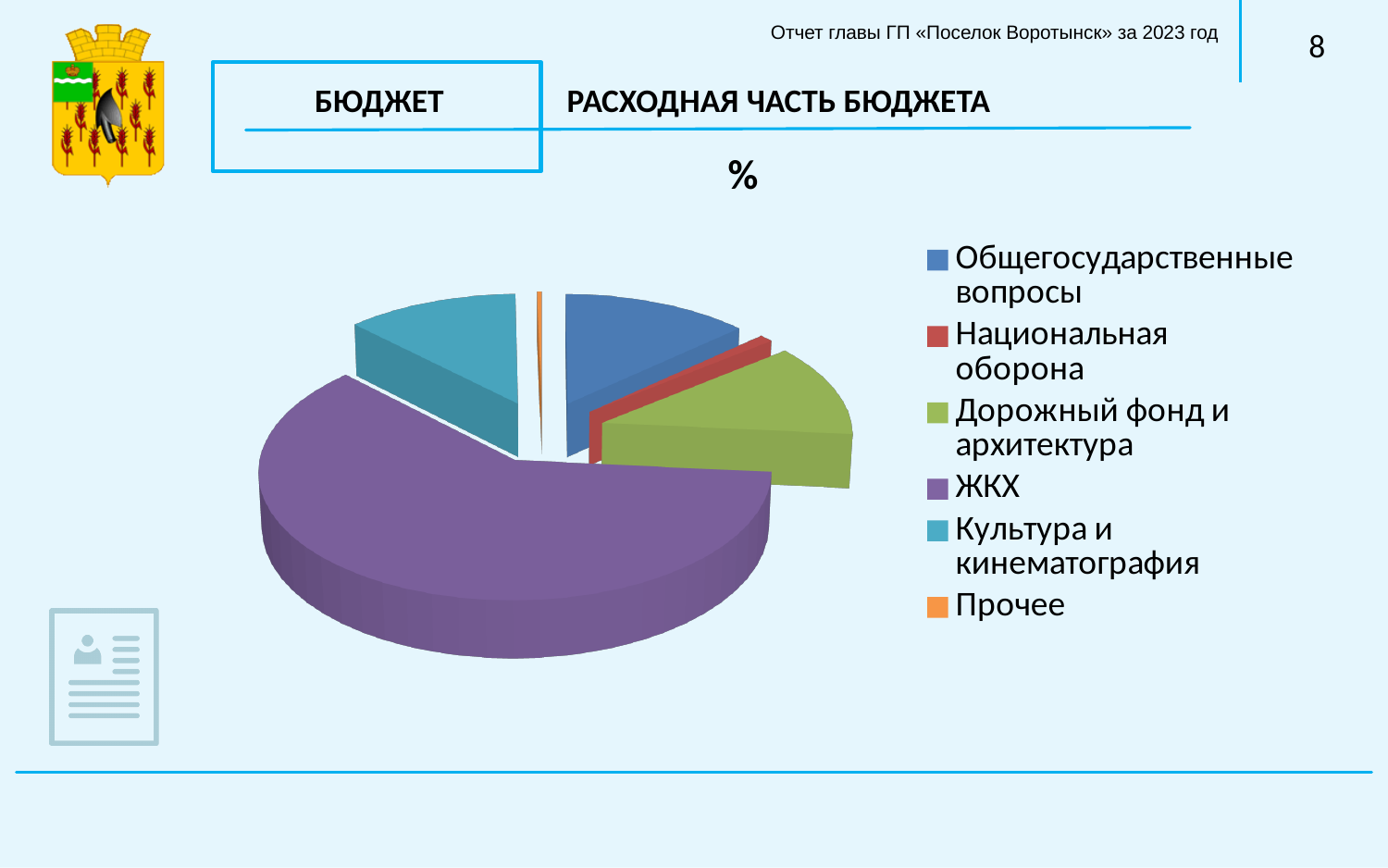
Which slice is larger: Дорожный фонд и архитектура or Национальная оборона? Дорожный фонд и архитектура What is the title shown above the pie chart? % Which category has the smallest slice of the pie chart? Прочее What colour is the ЖКХ slice in the pie chart? Purple What kind of chart is shown on the slide? Pie chart Which slice is larger: ЖКХ or Культура и кинематография? ЖКХ Which slice is larger: Общегосударственные вопросы or Прочее? Общегосударственные вопросы Which category has the largest slice of the pie chart? ЖКХ How many categories does the pie chart show? 6 How many entries does the legend of the pie chart list? 6